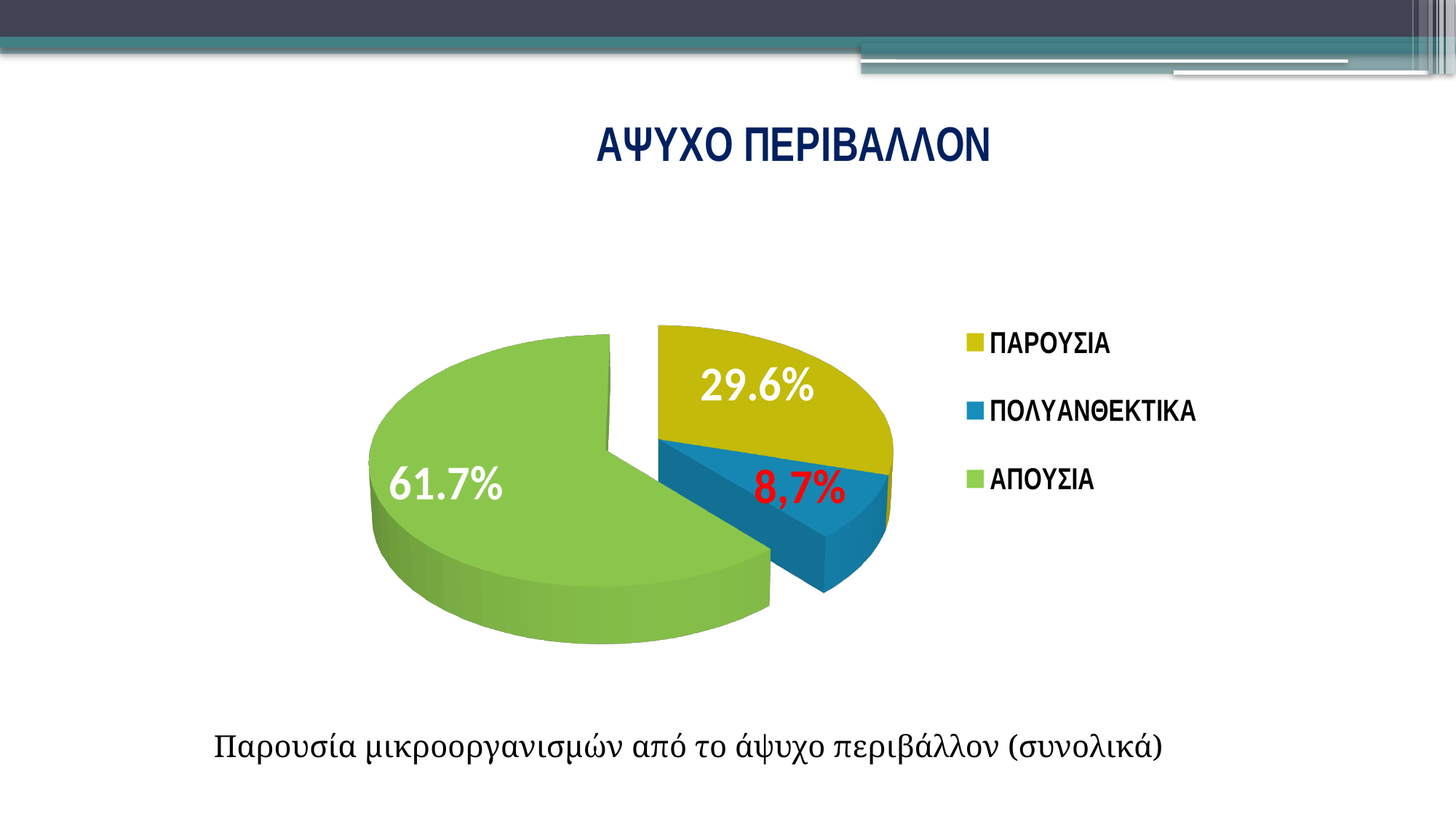
What kind of chart is shown on the slide? pie chart What is the title of the slide above the chart? ΑΨΥΧΟ ΠΕΡΙΒΑΛΛΟΝ What is the difference between the values for ΠΑΡΟΥΣΙΑ and ΠΟΛΥΑΝΘΕΚΤΙΚΑ? 20.9% What is the difference between the values for ΑΠΟΥΣΙΑ and ΠΑΡΟΥΣΙΑ? 32.1% Which category has the smallest slice of the pie? ΠΟΛΥΑΝΘΕΚΤΙΚΑ What is the value for ΠΑΡΟΥΣΙΑ? 29.6% Which is larger, the value for ΠΑΡΟΥΣΙΑ or the value for ΠΟΛΥΑΝΘΕΚΤΙΚΑ? ΠΑΡΟΥΣΙΑ Which category has the largest slice of the pie? ΑΠΟΥΣΙΑ What is the value for ΑΠΟΥΣΙΑ? 61.7% How many categories does the pie chart have? 3 What is the value for ΠΟΛΥΑΝΘΕΚΤΙΚΑ? 8,7% What colour is the slice for ΑΠΟΥΣΙΑ? green